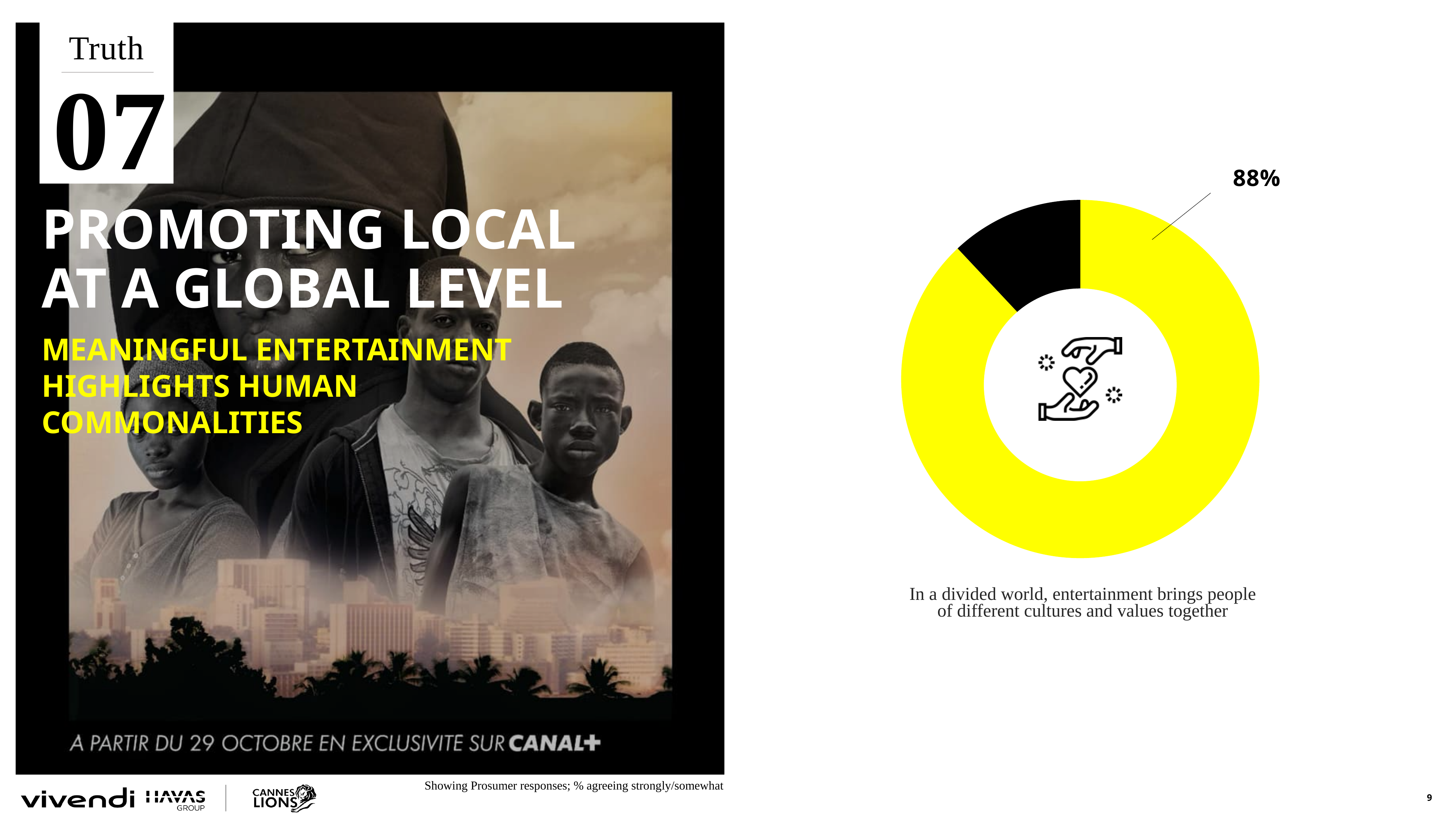
Is the value shown on the donut chart greater or less than 50%? greater How many segments does the donut chart have? 2 What colour is the segment labelled 88% in the donut chart? Yellow Which segment of the donut chart is larger, the yellow one or the black one? The yellow one What kind of chart is shown on the right side of the slide? Donut (pie) chart What statement does the 88% in the donut chart refer to, according to the caption below it? In a divided world, entertainment brings people of different cultures and values together What share of the donut chart does the yellow segment represent? 88% What percentage is shown as the data label on the donut chart? 88%